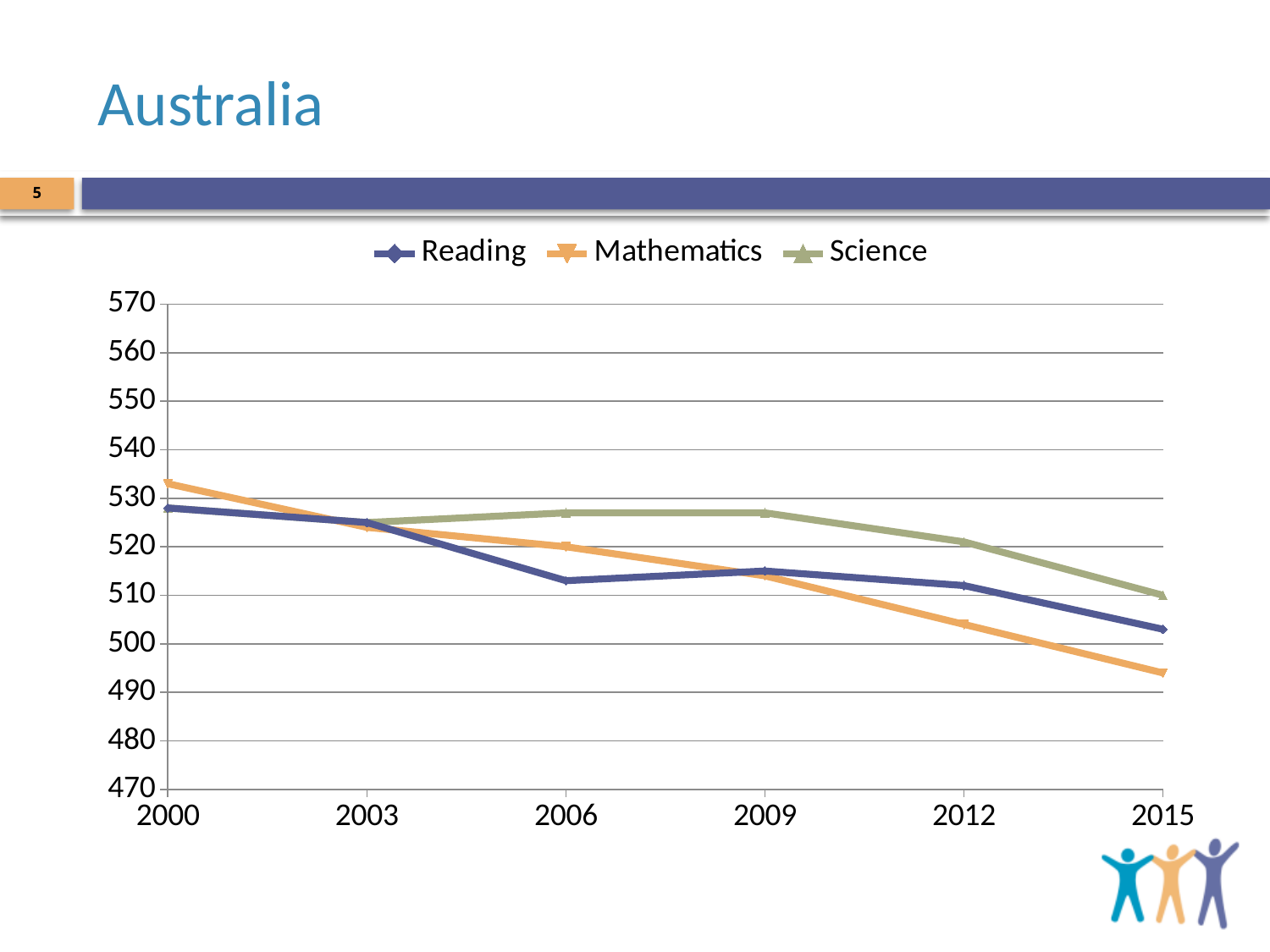
Which series has the highest value in 2015? Science What is the title of the slide containing the chart? Australia In 2015, which is higher, Reading or Mathematics? Reading Is the value for Science in 2009 greater or less than 520? greater Does the Mathematics line rise or fall from 2000 to 2015? fall Which series has the lowest value in 2015? Mathematics How many series does the legend list? 3 Is the value for Mathematics in 2015 greater or less than 500? less Is the value for Reading in 2006 greater or less than 520? less What kind of chart is shown on the slide? line chart How many years are shown along the x axis? 6